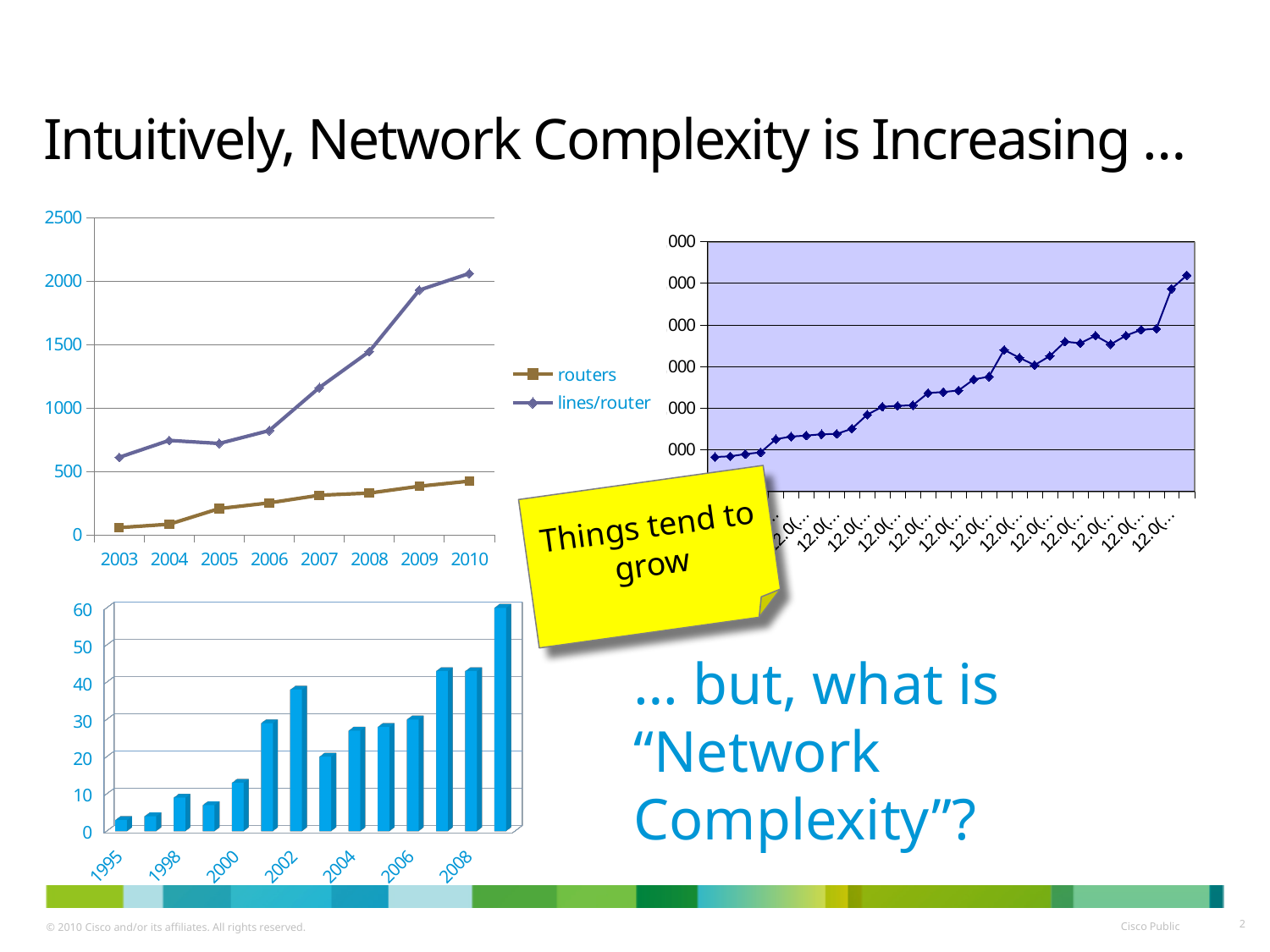
What kind of chart is the bottom-left chart with the years 1995 to 2008? bar chart In the top-left chart, do the lines/router values generally rise or fall from 2003 to 2010? rise How many series does the legend of the top-left chart list? 2 In the bottom-left bar chart, is the value for 2008 greater or less than 50? less In the top-left chart, which year has the highest lines/router value? 2010 In the top-left chart, is the routers value for 2010 greater or less than 500? less How many years are shown on the x axis of the top-left chart? 8 In the top-left chart, is the lines/router value for 2010 greater or less than 1500? greater What kind of chart is the top-left chart with the years 2003 to 2010? line chart In the top-left chart, which series has the higher value in 2010, routers or lines/router? lines/router What are the two series named in the legend of the top-left chart? routers and lines/router